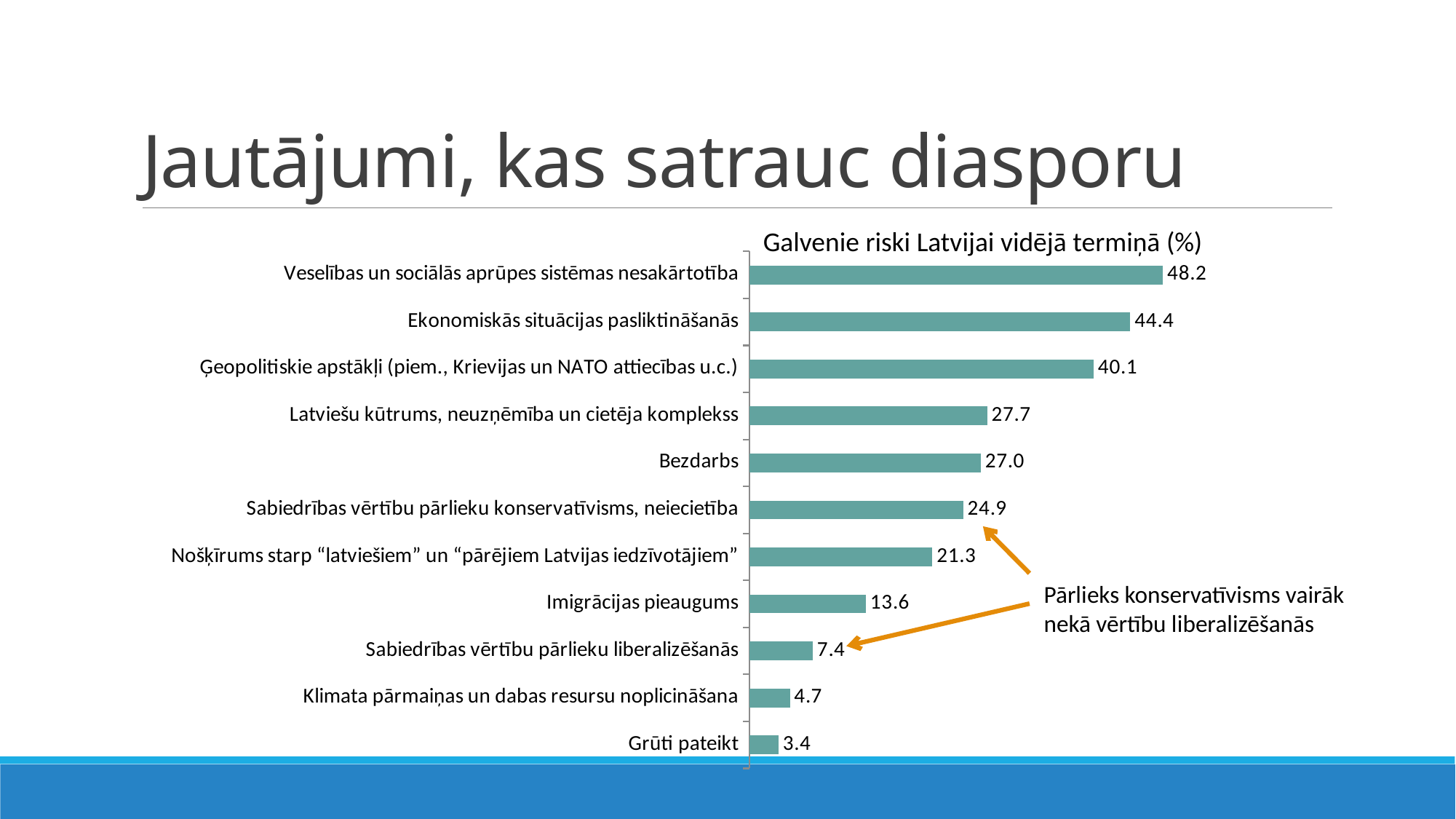
What is the value for Bezdarbs? 27.0 What is the value for Nošķīrums starp “latviešiem” un “pārējiem Latvijas iedzīvotājiem”? 21.3 How many categories are shown in the chart? 11 Which is larger: the value for Imigrācijas pieaugums or the value for Klimata pārmaiņas un dabas resursu noplicināšana? Imigrācijas pieaugums What is the difference between the values for Sabiedrības vērtību pārlieku konservatīvisms, neiecietība and Sabiedrības vērtību pārlieku liberalizēšanās? 17.5 Which category has the lowest value? Grūti pateikt Which category has the highest value? Veselības un sociālās aprūpes sistēmas nesakārtotība What is the title of the chart? Galvenie riski Latvijai vidējā termiņā (%) What is the value for Imigrācijas pieaugums? 13.6 What is the difference between the values for Veselības un sociālās aprūpes sistēmas nesakārtotība and Ekonomiskās situācijas pasliktināšanās? 3.8 What is the value for Ģeopolitiskie apstākļi (piem., Krievijas un NATO attiecības u.c.)? 40.1 What kind of chart is shown on the slide? Bar chart